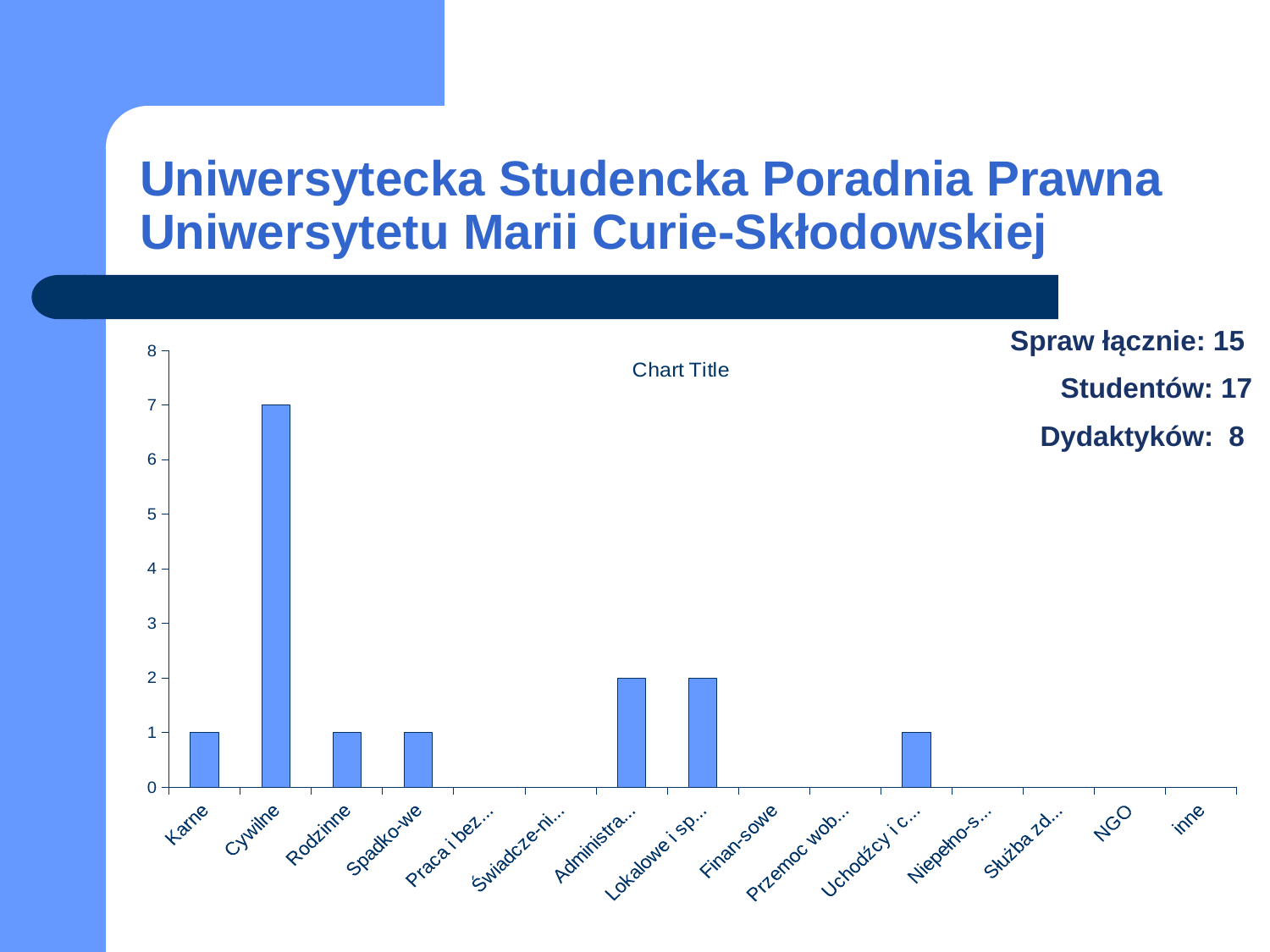
What is the difference between the values for Cywilne and Karne? 6 What type of chart is shown on the slide? bar chart What is the value for NGO? 0 Which is larger, the value for Cywilne or the value for Spadko-we? Cywilne What is the value for Rodzinne? 1 Which category has the highest value in the chart? Cywilne What is the highest value shown on the y axis of the chart? 8 What is the value for Karne? 1 How many categories are shown on the x axis of the chart? 15 What is the title of the chart? Chart Title What is the value for Cywilne? 7 Is the value for Cywilne greater or less than 5? greater